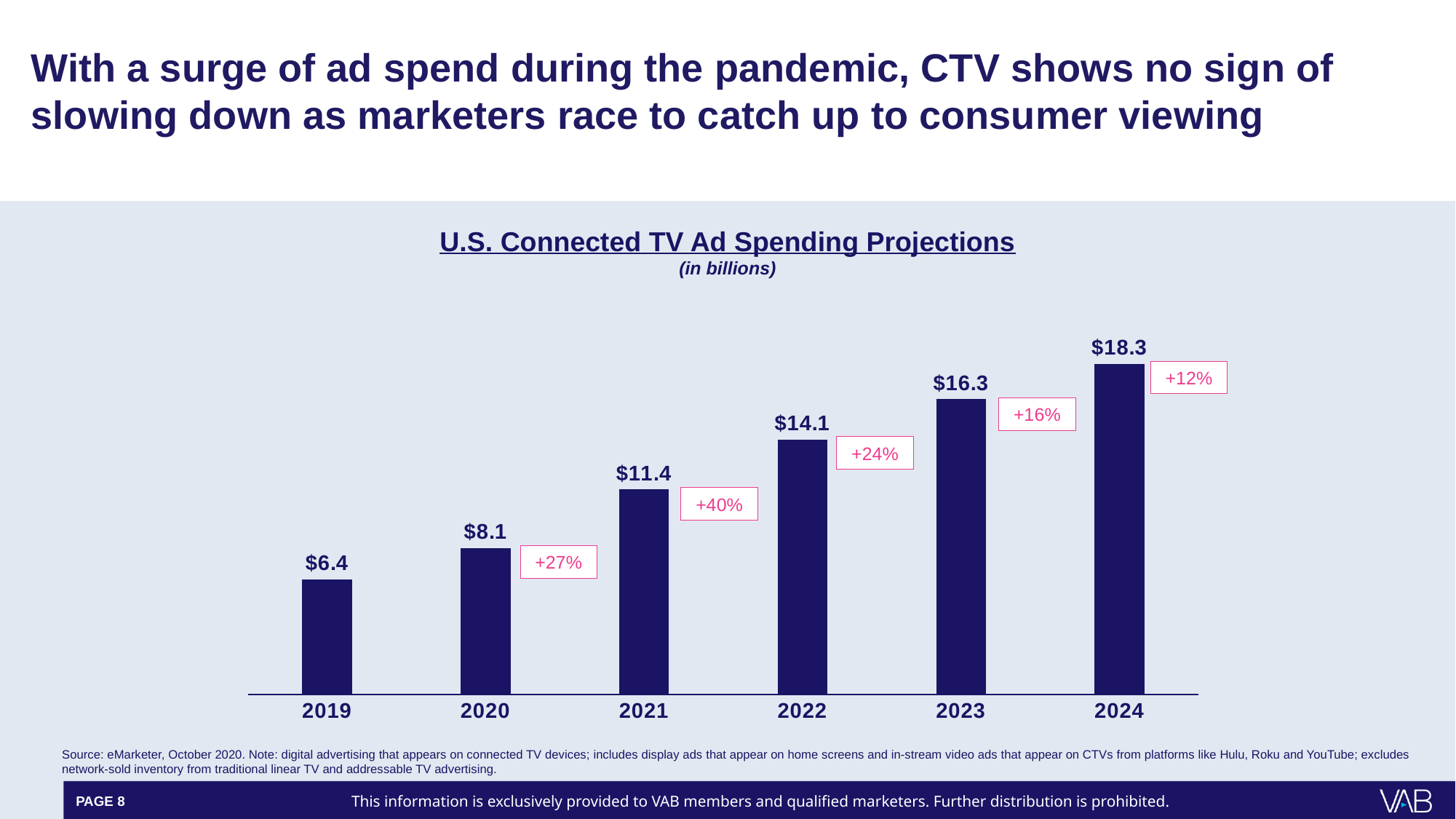
What is the value shown for 2019? $6.4 How many years are shown on the x axis? 6 Do the values rise or fall from 2019 to 2024? Rise Which year has the highest projected ad spending? 2024 What is the difference between the 2024 and 2023 values? $2.0 What is the projected U.S. connected TV ad spending for 2021? $11.4 What is the difference between the 2022 and 2020 values? $6.0 Which year has the lowest projected ad spending? 2019 What kind of chart is shown on the slide? Bar chart Which is larger, the value for 2021 or the value for 2022? 2022 What is the projected U.S. connected TV ad spending for 2024? $18.3 What year-over-year percentage growth is labeled next to the 2021 bar? +40%